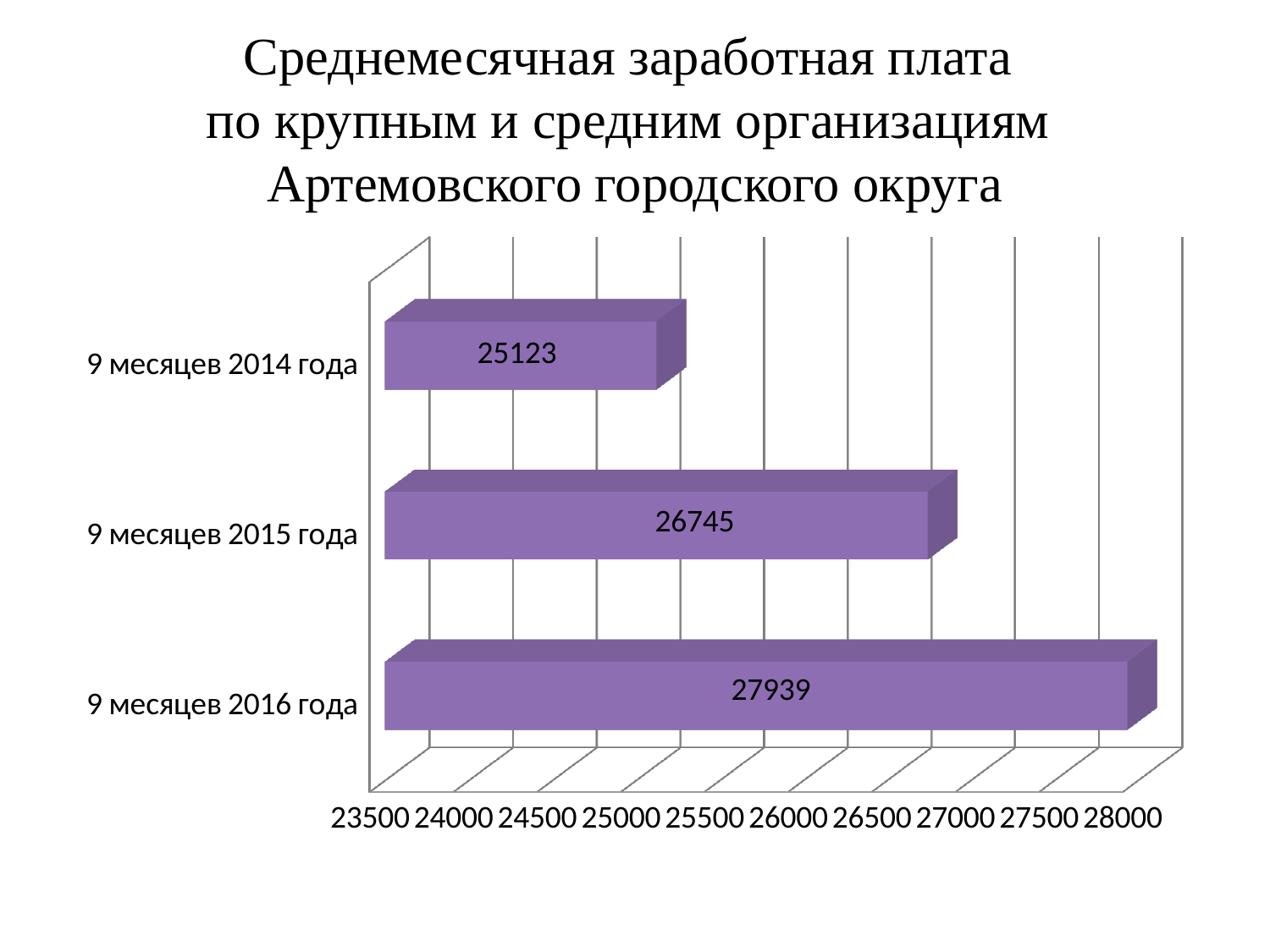
What is the value for 9 месяцев 2015 года? 26745 Which is larger, the value for 9 месяцев 2014 года or 9 месяцев 2015 года? 9 месяцев 2015 года Is the value for 9 месяцев 2016 года greater or less than 27500? greater How many categories are shown in the chart? 3 What is the value for 9 месяцев 2014 года? 25123 What is the difference between the values for 9 месяцев 2016 года and 9 месяцев 2015 года? 1194 What is the difference between the values for 9 месяцев 2015 года and 9 месяцев 2014 года? 1622 What kind of chart is shown on the slide? bar chart What is the title of the chart on the slide? Среднемесячная заработная плата по крупным и средним организациям Артемовского городского округа Which category has the highest value? 9 месяцев 2016 года What is the value for 9 месяцев 2016 года? 27939 Which category has the lowest value? 9 месяцев 2014 года